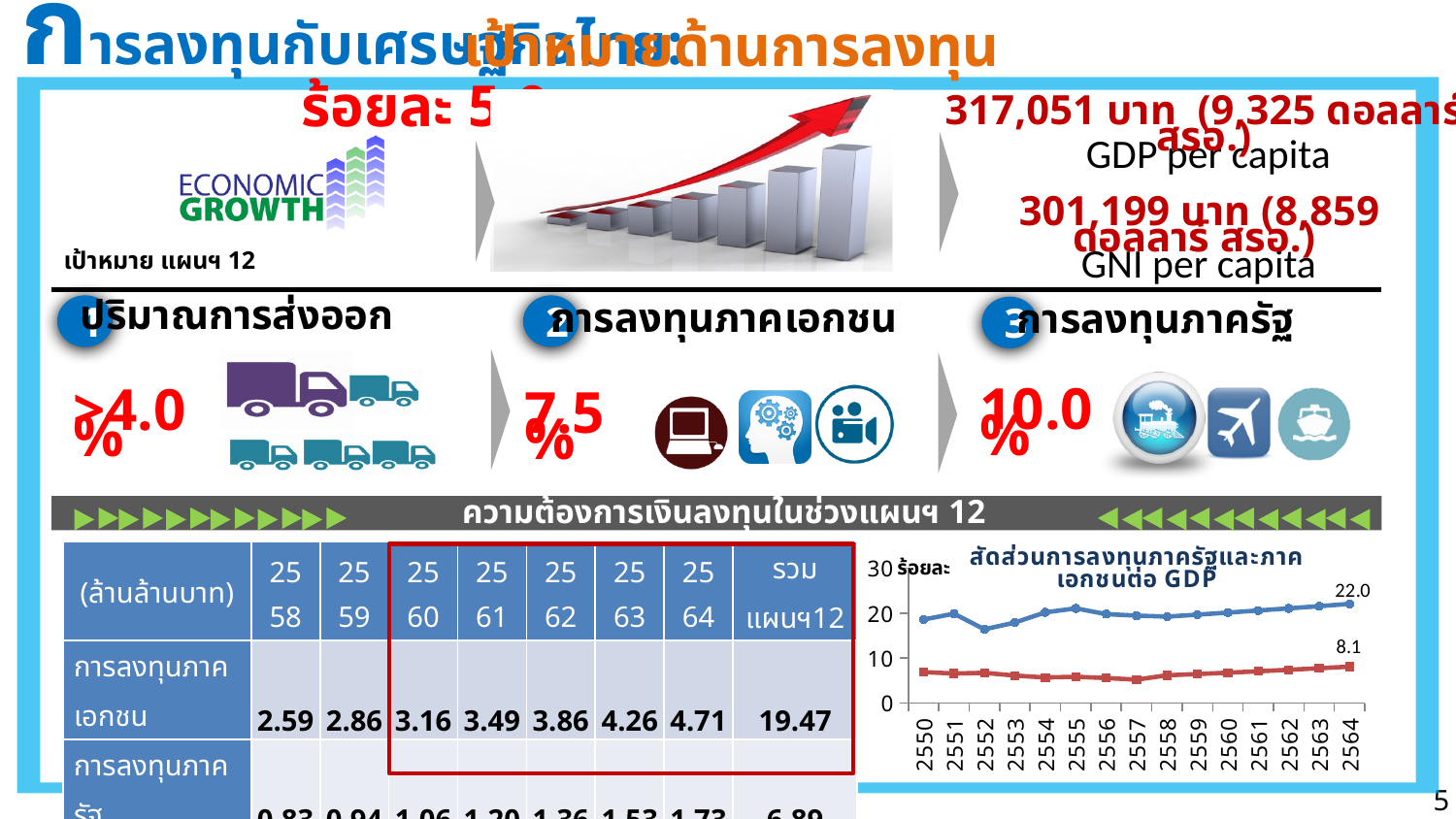
In the line chart, does the red line rise or fall from 2557 to 2564? rise In the line chart, is the value of the blue line at 2552 greater or less than 20? less How many years are shown on the x axis of the line chart? 15 In the line chart, what is the difference between the blue line's value and the red line's value at 2564? 13.9 In the line chart, what is the labelled value of the blue (upper) line at 2564? 22.0 In the line chart, is the value of the blue line at 2550 greater or less than 10? greater In the line chart, which line has the higher value at 2564, the blue line or the red line? blue line What kind of chart is shown at the bottom right of the slide? line chart What is the title of the line chart at the bottom right of the slide? สัดส่วนการลงทุนภาครัฐและภาคเอกชนต่อ GDP In the line chart, what is the labelled value of the red (lower) line at 2564? 8.1 What is the unit label shown on the y axis of the line chart? ร้อยละ In the line chart, is the value of the red line at 2550 greater or less than 10? less